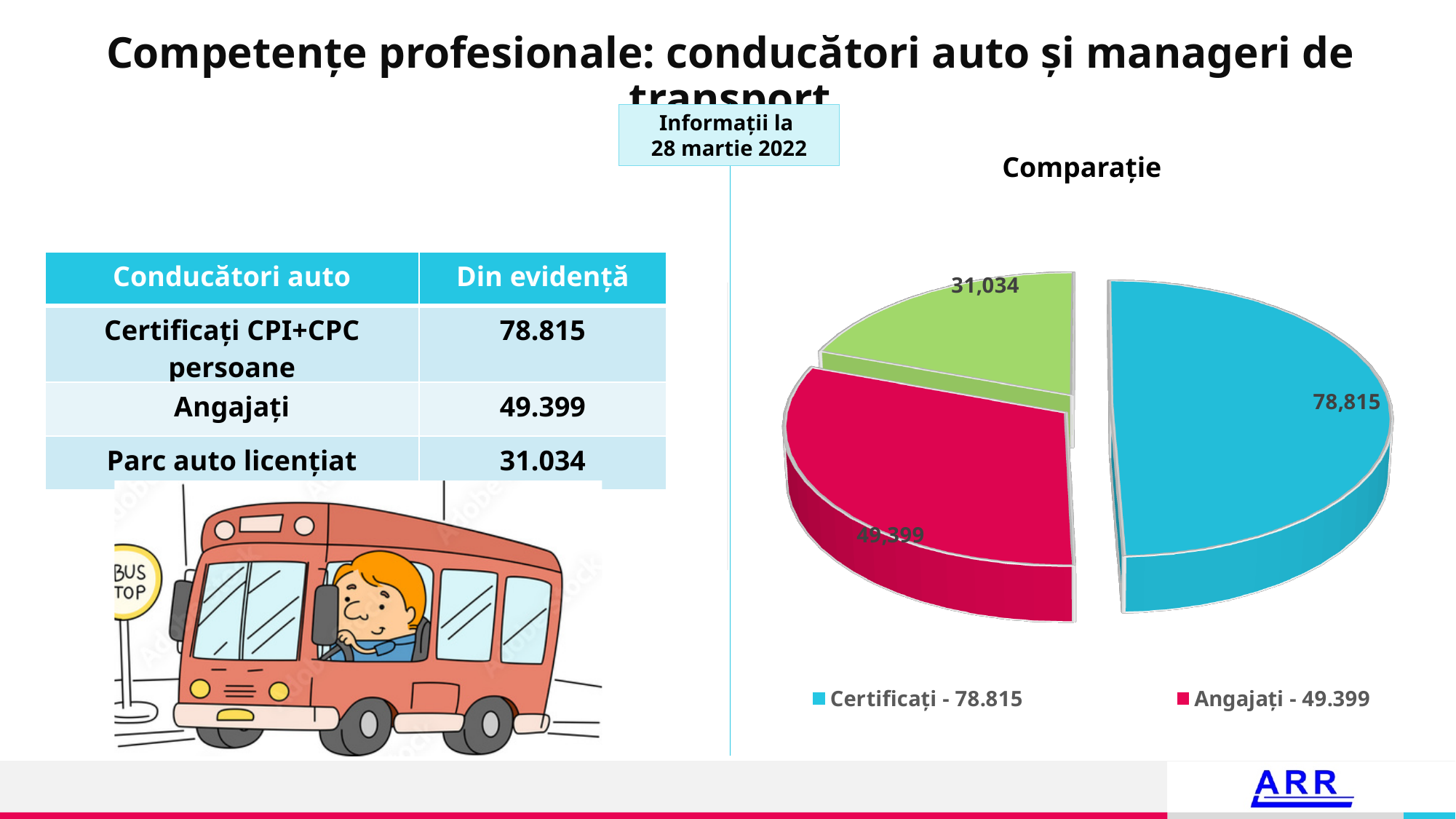
How many entries does the pie chart's legend list? 2 How many slices does the pie chart have? 3 What is the smallest value labelled on the pie chart? 31,034 What is the difference between the Certificați value and the Angajați value in the pie chart? 29,416 What is the difference between the largest slice (78,815) and the smallest slice (31,034) in the pie chart? 47,781 What is the title of the chart on the right side of the slide? Comparație What value is shown on the pie chart for Certificați? 78,815 What colour is the Certificați slice in the pie chart? blue What value is shown on the pie chart for Angajați? 49,399 Which legend category has the largest slice in the pie chart? Certificați What kind of chart is shown under the title "Comparație"? pie chart Which is larger in the pie chart, Certificați or Angajați? Certificați